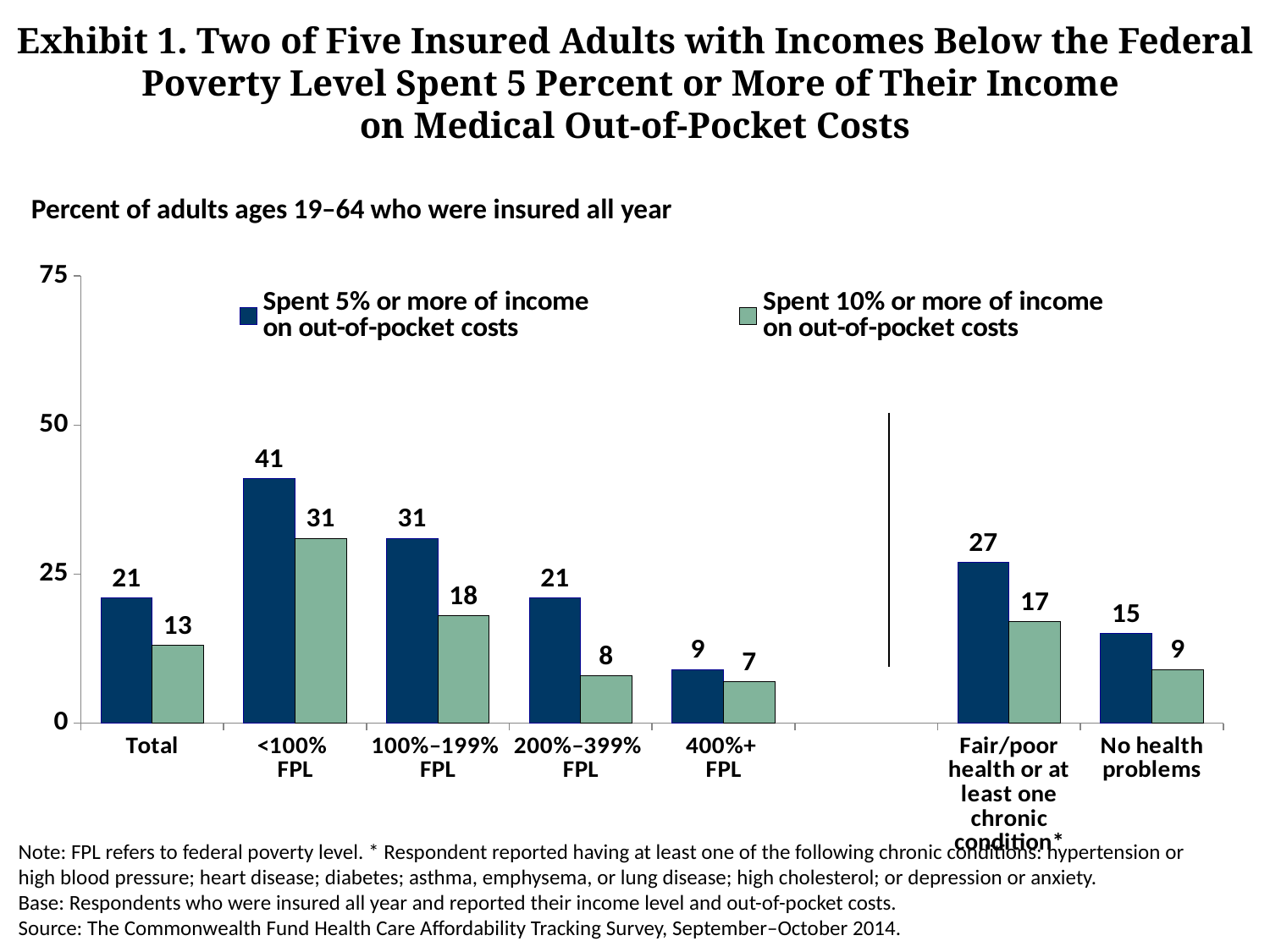
Which category has the lowest value for 'Spent 10% or more of income on out-of-pocket costs'? 400%+ FPL What is the value for 'Spent 5% or more of income on out-of-pocket costs' in the <100% FPL category? 41 What is the value for 'Spent 10% or more of income on out-of-pocket costs' in the Fair/poor health or at least one chronic condition category? 17 What is the difference between the 'Spent 5% or more' and 'Spent 10% or more' values in the 100%–199% FPL category? 13 What kind of chart is shown on the slide? bar chart How many series does the legend list? 2 Which is larger: the 'Spent 5% or more' value for 200%–399% FPL or the 'Spent 5% or more' value for No health problems? 200%–399% FPL What is the value for 'Spent 10% or more of income on out-of-pocket costs' in the Total category? 13 Across the income categories from <100% FPL to 400%+ FPL, do the 'Spent 10% or more' values rise or fall? fall Is the 'Spent 5% or more' value for Fair/poor health or at least one chronic condition greater or less than 25? greater How many categories are shown on the x axis? 7 Which category has the highest value for 'Spent 5% or more of income on out-of-pocket costs'? <100% FPL